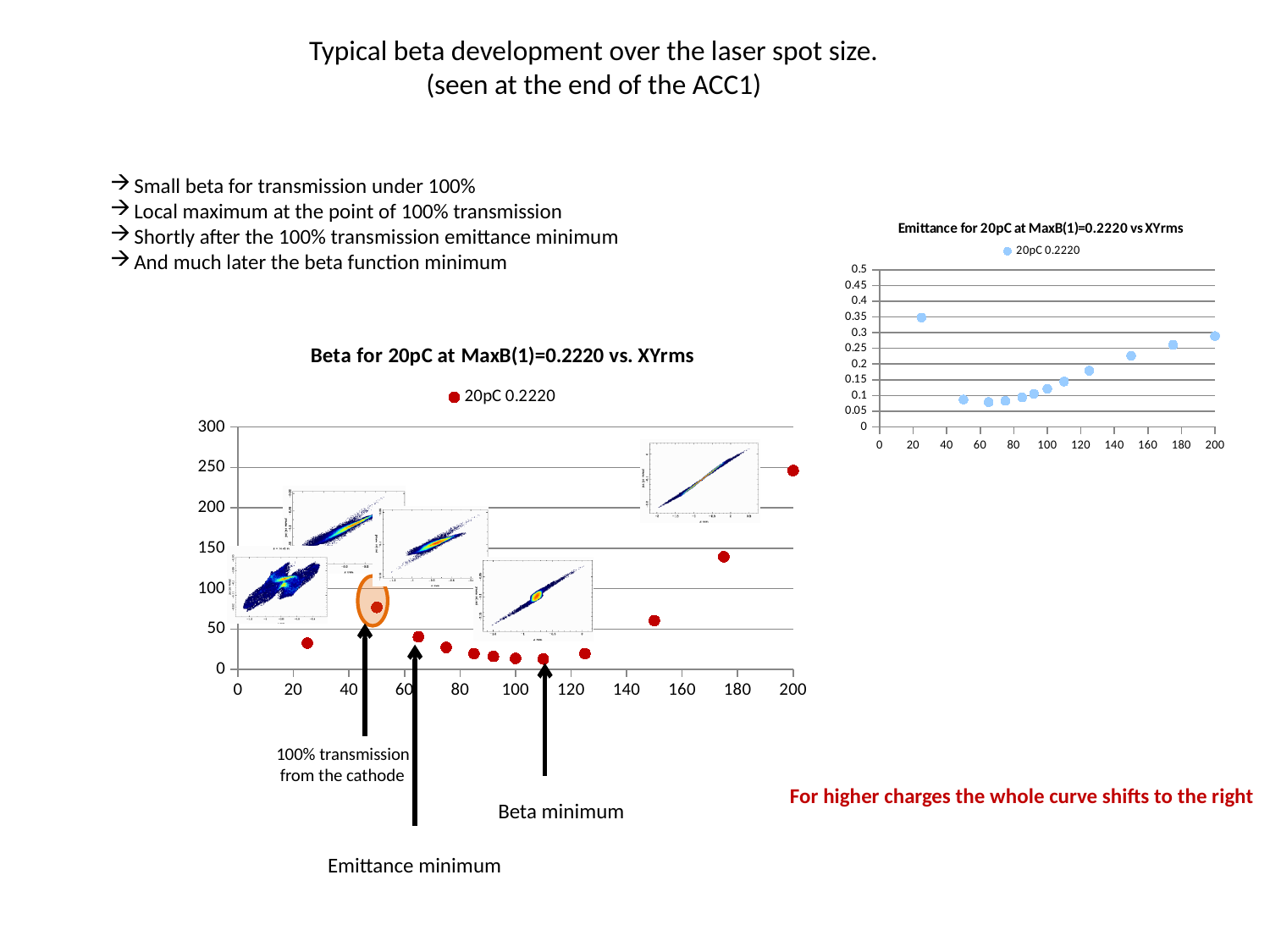
On the 'Beta for 20pC at MaxB(1)=0.2220 vs. XYrms' chart, at which x value is the beta value highest? 200 How many data points are plotted on the 'Beta for 20pC at MaxB(1)=0.2220 vs. XYrms' chart? 12 On the 'Emittance for 20pC at MaxB(1)=0.2220 vs XYrms' chart, is the value at x = 150 greater or less than 0.2? greater On the 'Beta for 20pC at MaxB(1)=0.2220 vs. XYrms' chart, is the value at x = 200 greater or less than 200? greater What colour are the data points on the 'Emittance for 20pC at MaxB(1)=0.2220 vs XYrms' chart? light blue How many series does the legend of the 'Beta for 20pC at MaxB(1)=0.2220 vs. XYrms' chart list? 1 On the 'Beta for 20pC at MaxB(1)=0.2220 vs. XYrms' chart, is the value at x = 150 greater or less than 100? less What is the legend entry on the 'Emittance for 20pC at MaxB(1)=0.2220 vs XYrms' chart? 20pC 0.2220 On the 'Beta for 20pC at MaxB(1)=0.2220 vs. XYrms' chart, which is larger: the value at x = 175 or the value at x = 150? x = 175 What type of chart is the 'Beta for 20pC at MaxB(1)=0.2220 vs. XYrms' chart? scatter chart On the 'Emittance for 20pC at MaxB(1)=0.2220 vs XYrms' chart, do the values rise or fall between x = 100 and x = 200? rise